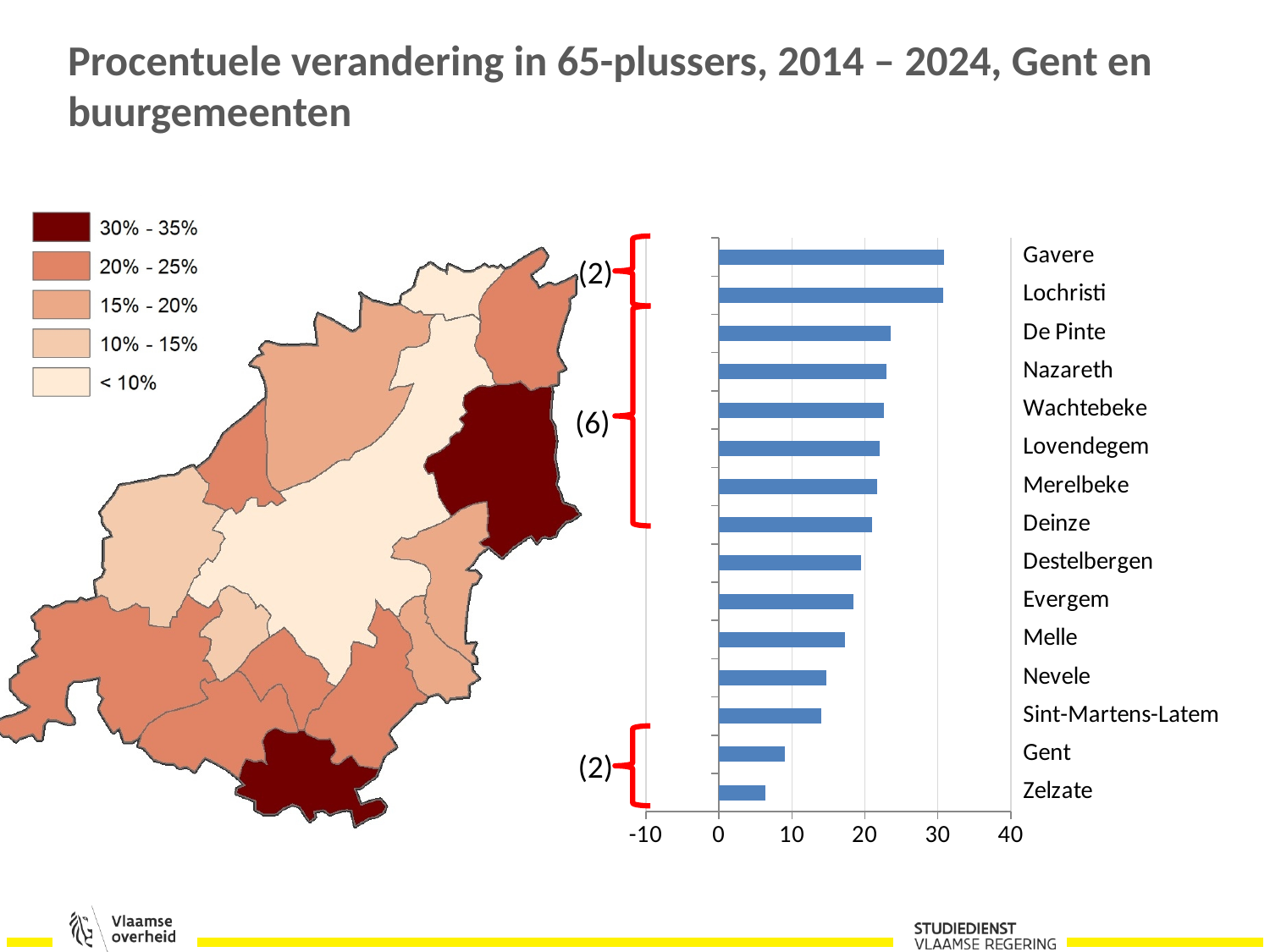
How many municipalities are listed in the bar chart? 15 Do the bar values increase or decrease going from the top of the chart (Gavere) to the bottom (Zelzate)? decrease Which has the larger value, Gavere or Gent? Gavere Which has the larger value, Melle or Nevele? Melle Is the value for De Pinte greater or less than 20? greater What kind of chart is shown on the right side of the slide? bar chart Which municipality has the lowest value in the bar chart? Zelzate Is the value for Evergem greater or less than 20? less Is the value for Nevele greater or less than 10? greater How many colour classes does the map legend show? 5